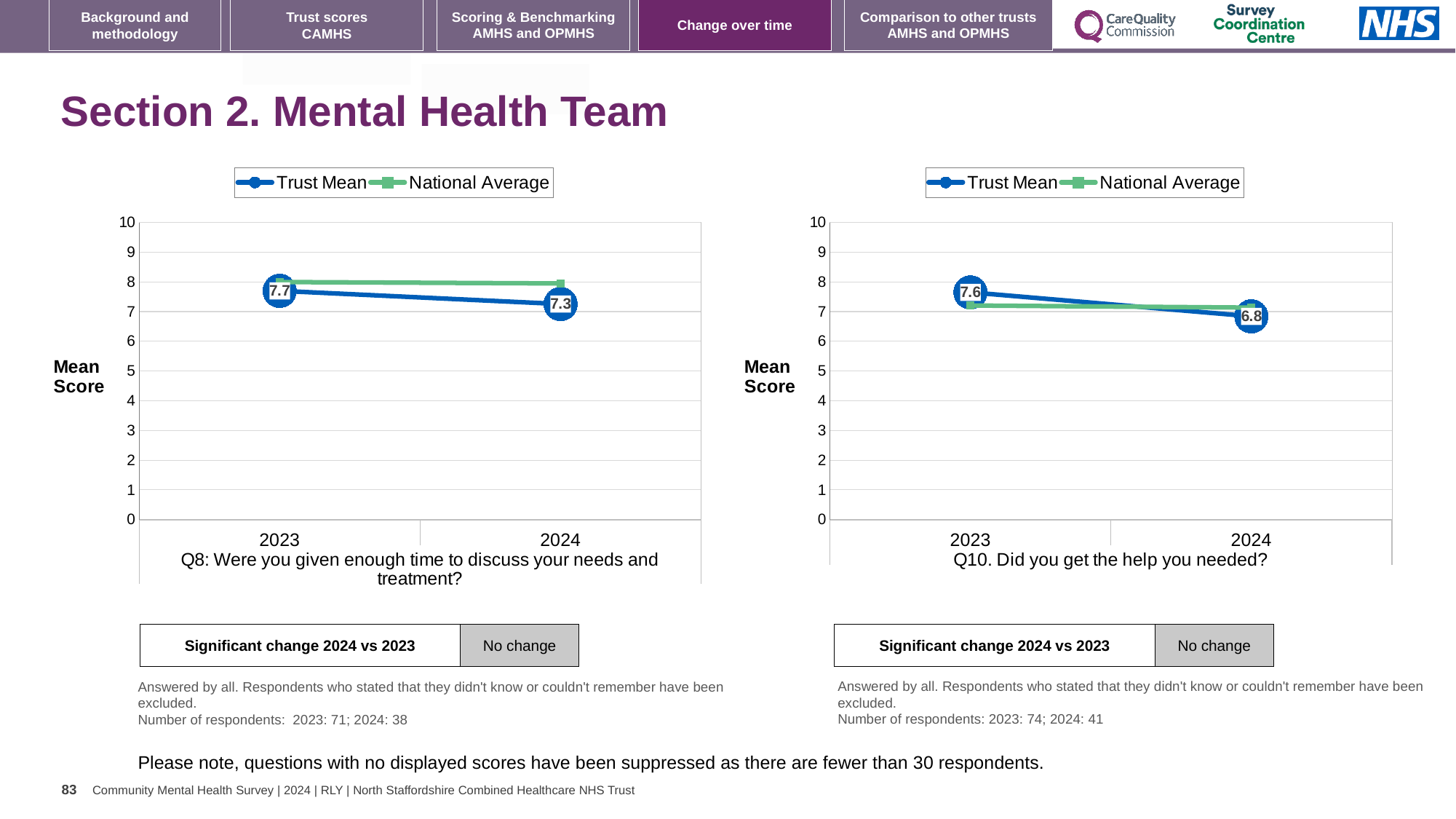
In the Q8 chart on the left, what is the Trust Mean score for 2024? 7.3 In the Q10 chart on the right, what is the Trust Mean score for 2024? 6.8 What type of chart is the Q8 chart on the left? line chart In the Q10 chart on the right, does the Trust Mean rise or fall from 2023 to 2024? fall How many series does the legend of the Q10 chart on the right list? 2 In the Q10 chart on the right, which is larger for 2023: the Trust Mean or the National Average? Trust Mean In the Q10 chart on the right, by how much did the Trust Mean change from 2023 to 2024? 0.8 In the Q10 chart on the right, what is the Trust Mean score for 2023? 7.6 In the Q10 chart on the right, is the National Average value for 2024 greater or less than 8? less In the Q8 chart on the left, by how much did the Trust Mean change from 2023 to 2024? 0.4 How many years are plotted on the x axis of the Q8 chart on the left? 2 In the Q8 chart on the left, what is the Trust Mean score for 2023? 7.7